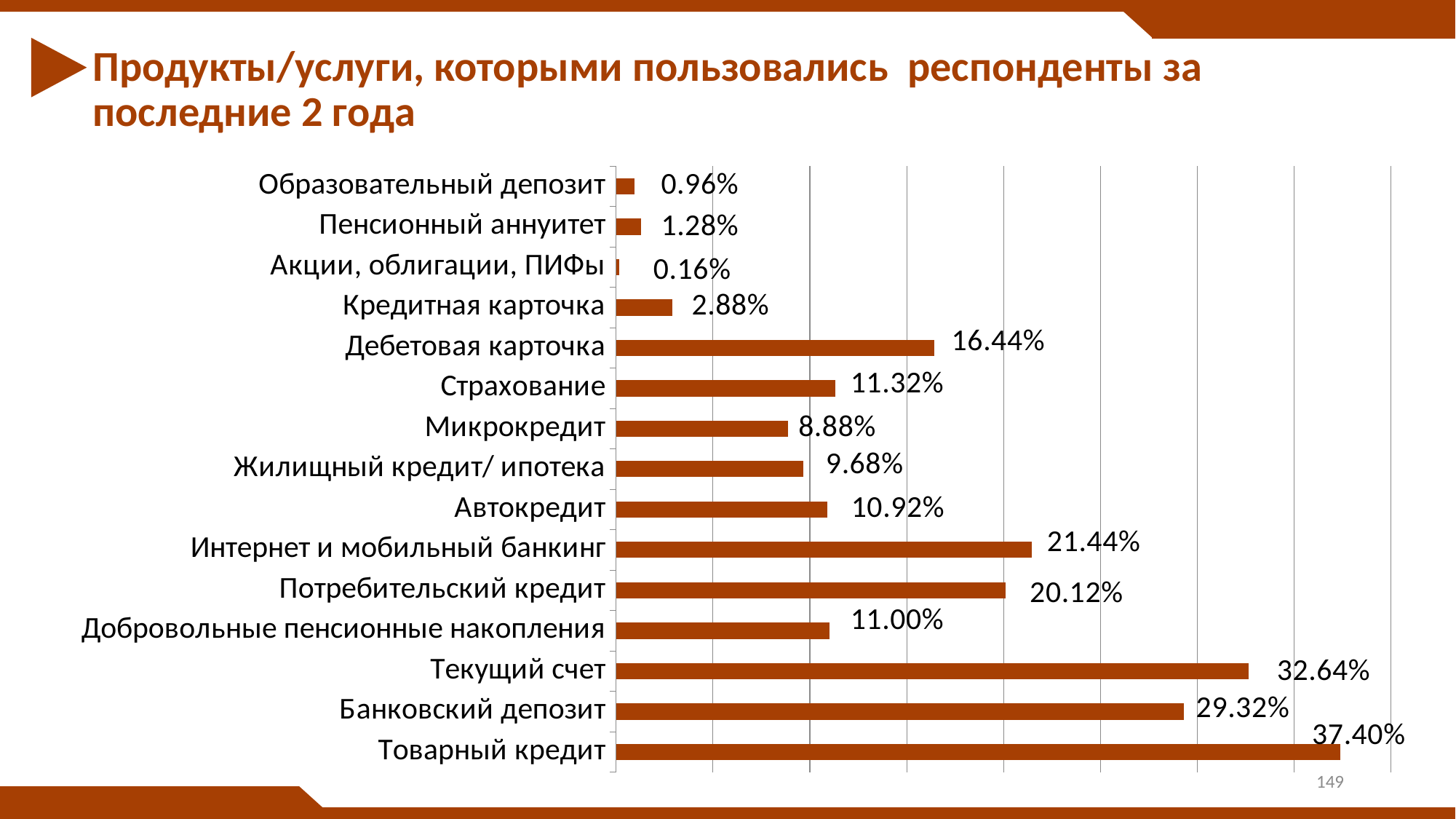
What value is shown for Интернет и мобильный банкинг? 21.44% How many categories are shown in the chart? 15 Which category has the highest value? Товарный кредит What value is shown for Товарный кредит? 37.40% Which is larger, the value for Микрокредит or the value for Жилищный кредит/ ипотека? Жилищный кредит/ ипотека What is the difference between the values for Дебетовая карточка and Страхование? 5.12% Which category has the lowest value? Акции, облигации, ПИФы What is the difference between the values for Товарный кредит and Текущий счет? 4.76% What value is shown for Акции, облигации, ПИФы? 0.16% What kind of chart is shown on the slide? Bar chart What value is shown for Добровольные пенсионные накопления? 11.00% Which is larger, the value for Банковский депозит or the value for Потребительский кредит? Банковский депозит